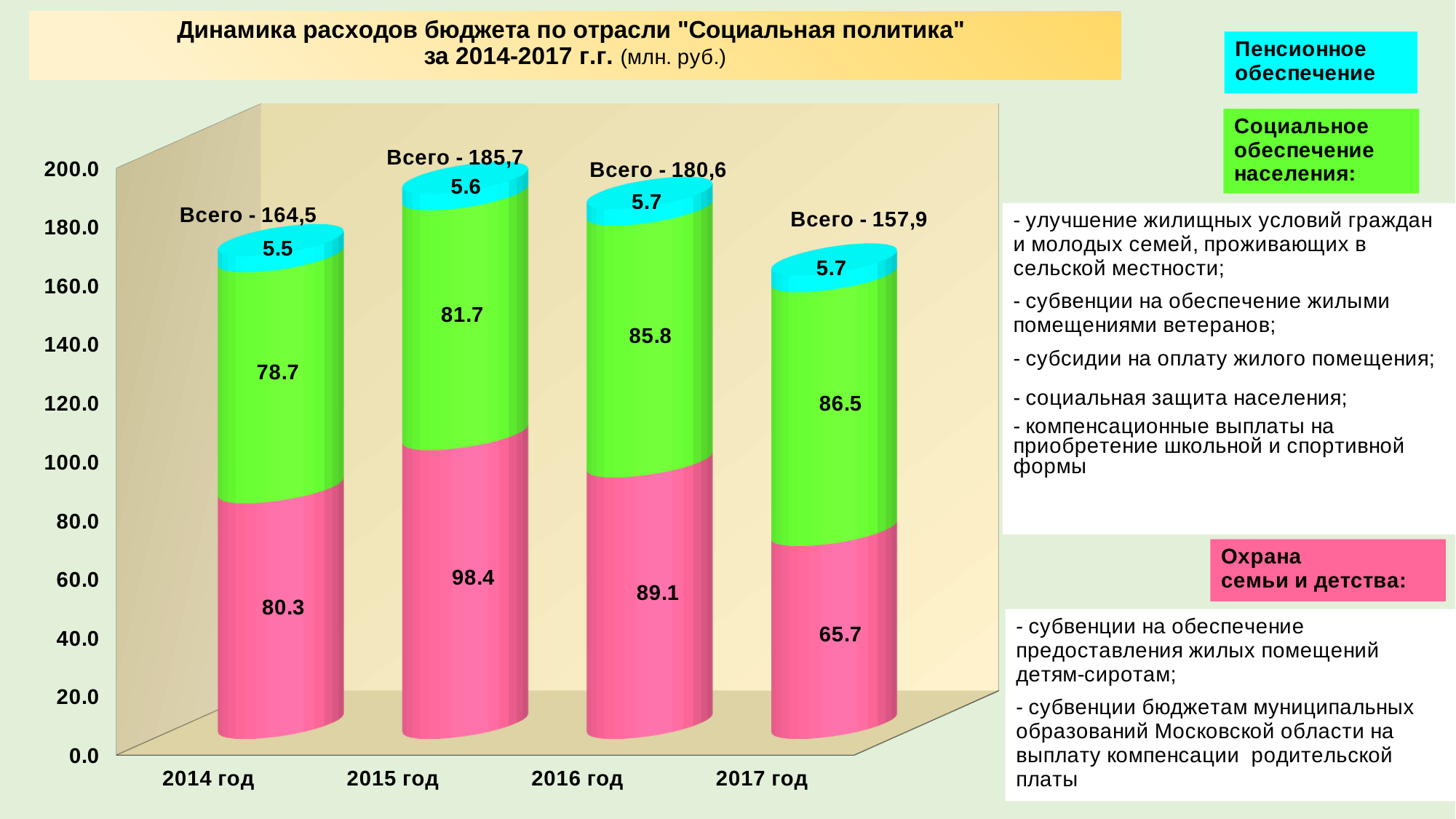
Which is larger: the Охрана семьи и детства value in 2016 год or in 2017 год? 2016 год How many years (categories) are shown on the x axis of the chart? 4 Which colour represents Пенсионное обеспечение in the chart? cyan (light blue) What is the total (Всего) for 2016 год? 180,6 What is the value for Пенсионное обеспечение in 2014 год? 5.5 How does the Социальное обеспечение населения value change from 2014 год to 2017 год? It rises What is the value for Охрана семьи и детства in 2015 год? 98.4 Which year has the lowest value for Охрана семьи и детства? 2017 год What is the value for Социальное обеспечение населения in 2017 год? 86.5 What type of chart is shown on the slide? stacked bar chart What is the difference between the Социальное обеспечение населения values for 2016 год and 2014 год? 7.1 Which year has the highest total (Всего)? 2015 год